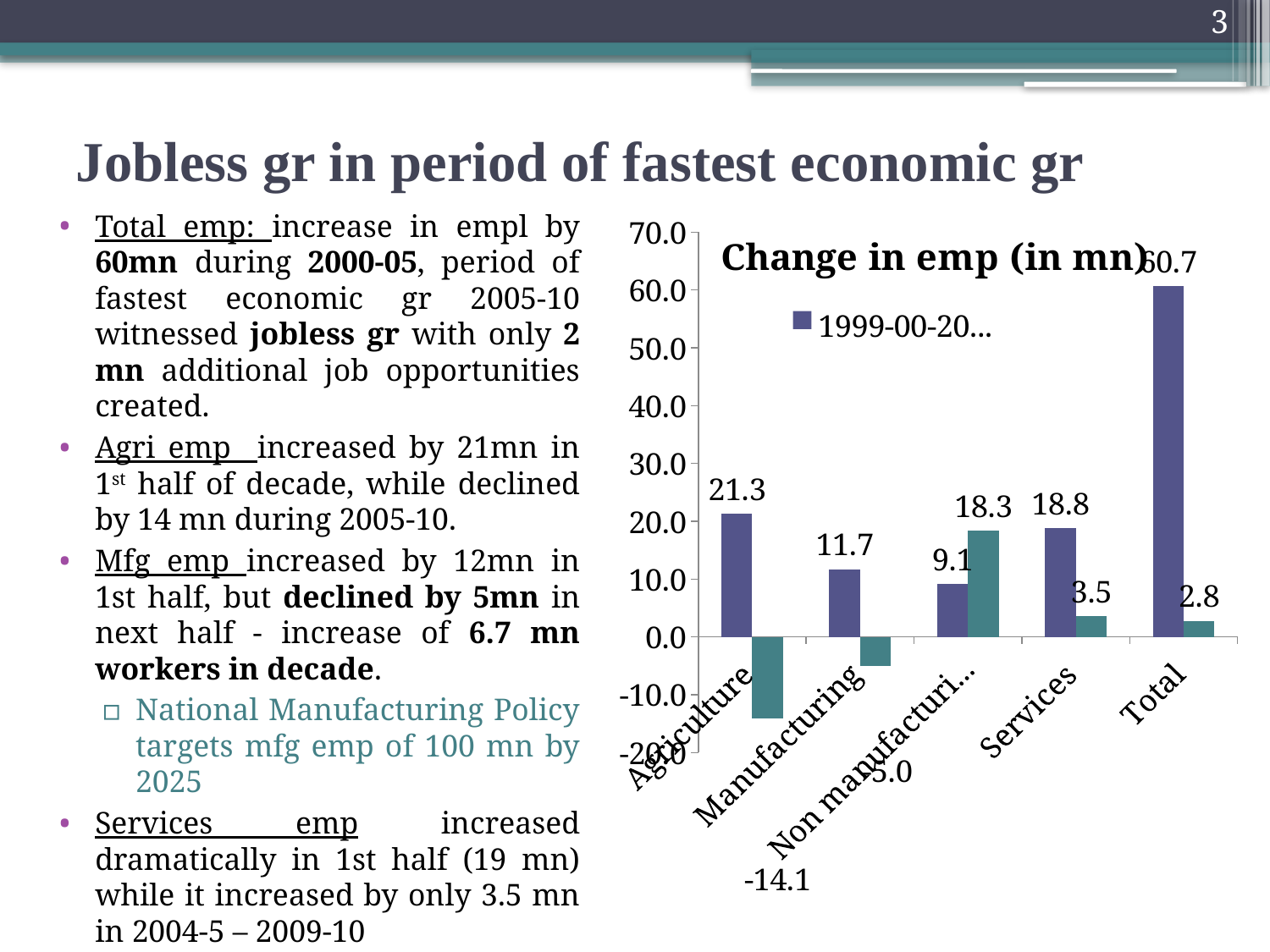
Which category has the highest purple bar? Total What is the value of the purple bar for Agriculture? 21.3 Which category has the lowest teal bar? Agriculture What is the value of the purple bar for Services? 18.8 What is the difference between the purple bar and the teal bar for Services? 15.3 How many categories are shown on the x axis of the chart? 5 What kind of chart is shown on the slide? bar chart What is the value of the teal bar for Non manufacturing? 18.3 What is the value of the teal bar for Total? 2.8 Which purple bar is larger, Manufacturing or Non manufacturing? Manufacturing What is the value of the teal bar for Agriculture? -14.1 What is the title of the chart? Change in emp (in mn)